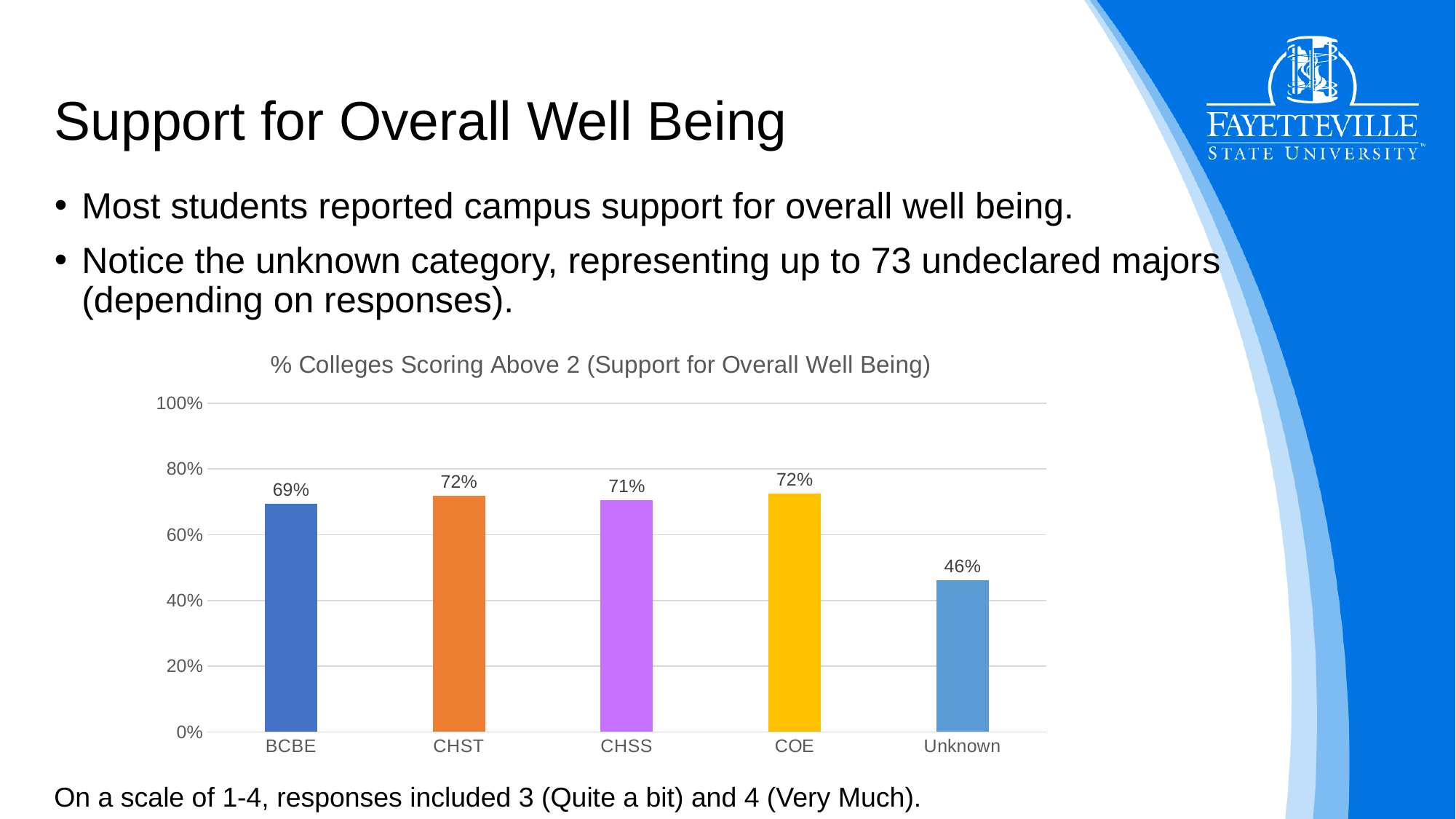
Which is larger, the value for COE or the value for Unknown? COE Which category has the lowest value? Unknown What is the value for COE? 72% What is the title of the chart? % Colleges Scoring Above 2 (Support for Overall Well Being) How many categories are shown on the x axis? 5 What is the value for Unknown? 46% Is the value for Unknown greater or less than 60%? less What is the difference between the values for CHST and Unknown? 26% What is the difference between the values for CHSS and BCBE? 2% What is the value for BCBE? 69% What is the value for CHSS? 71% What kind of chart is shown on the slide? bar chart